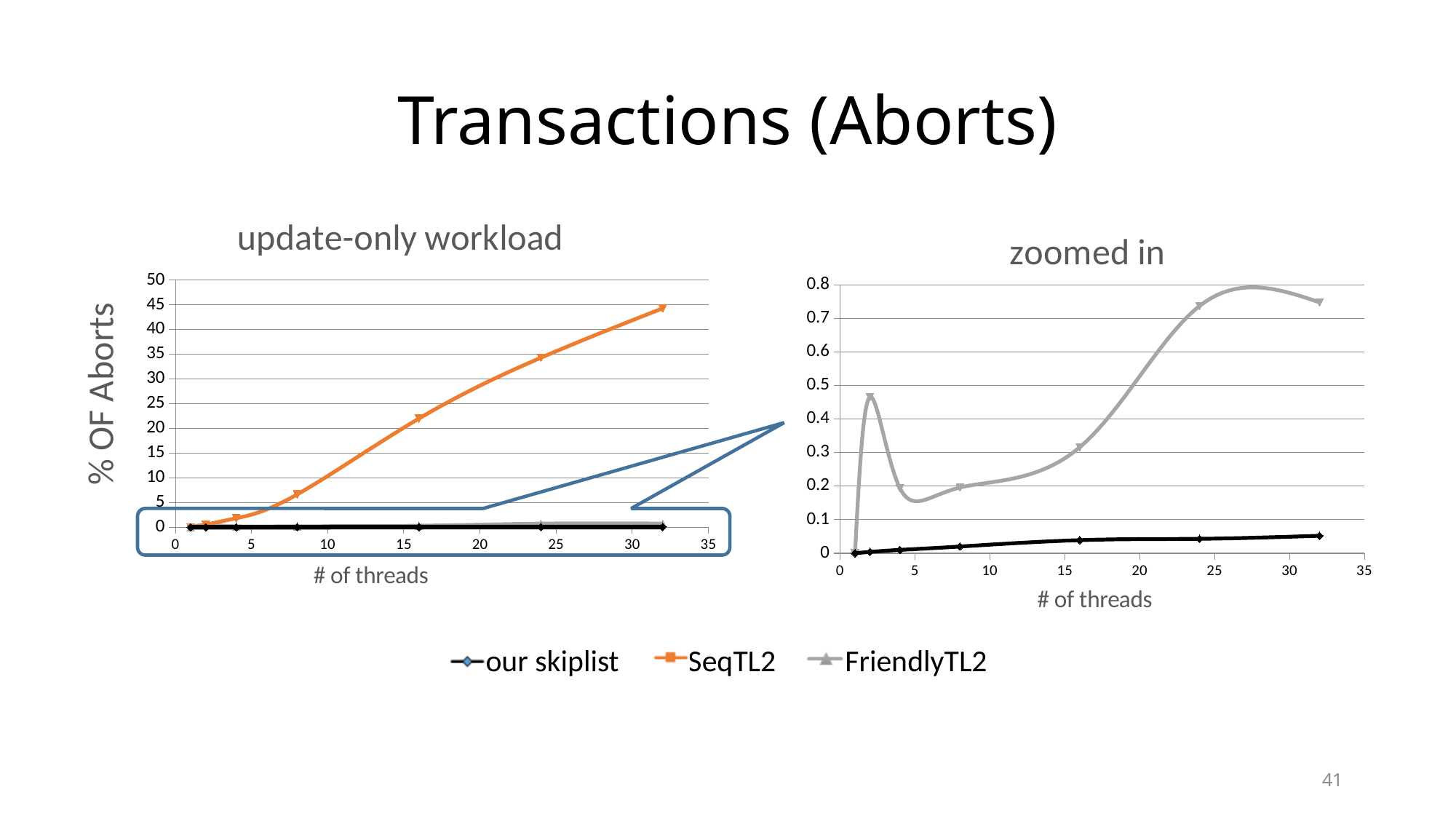
In the "zoomed in" chart, is the value for our skiplist at 32 threads greater or less than 0.1? less In the "update-only workload" chart, is the value for SeqTL2 at 16 threads greater or less than 25? less In the "update-only workload" chart, is the value for SeqTL2 at 32 threads greater or less than 40? greater How many series does the legend list? 3 In the "update-only workload" chart, which series has the highest value at 32 threads? SeqTL2 In the "zoomed in" chart, which is larger at 16 threads: FriendlyTL2 or our skiplist? FriendlyTL2 In the "update-only workload" chart, does the SeqTL2 series rise or fall as the number of threads increases? rise What is the y-axis label of the "update-only workload" chart? % OF Aborts What kind of chart is the "update-only workload" chart? line chart In the "zoomed in" chart, how many data points are plotted for the FriendlyTL2 series? 7 In the "update-only workload" chart, which is larger at 24 threads: SeqTL2 or our skiplist? SeqTL2